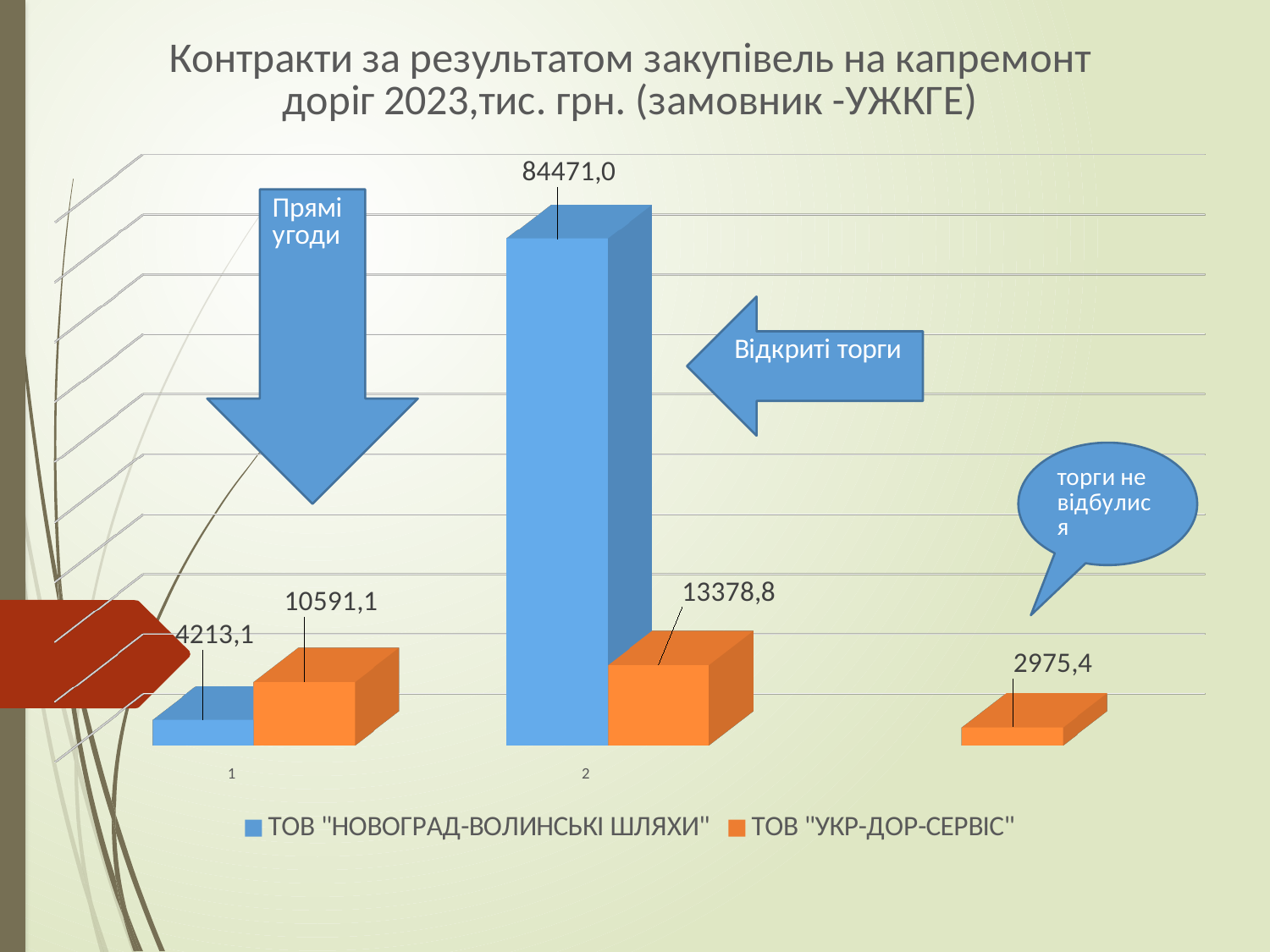
Which annotation arrow points to category 2 of the chart? Відкриті торги How many series does the legend list? 2 What is the smallest value labelled on the chart? 2975,4 What is the difference between the two series' values in category 2? 71092,2 What is the value for ТОВ "НОВОГРАД-ВОЛИНСЬКІ ШЛЯХИ" in category 1? 4213,1 In category 1, which series has the larger value? ТОВ "УКР-ДОР-СЕРВІС" What kind of chart is shown on the slide? Bar chart What is the value for ТОВ "УКР-ДОР-СЕРВІС" in category 1? 10591,1 What is the value for ТОВ "УКР-ДОР-СЕРВІС" in category 2? 13378,8 Which series has the highest value on the chart? ТОВ "НОВОГРАД-ВОЛИНСЬКІ ШЛЯХИ" What is the difference between the two series' values in category 1? 6378,0 What is the value for ТОВ "НОВОГРАД-ВОЛИНСЬКІ ШЛЯХИ" in category 2? 84471,0